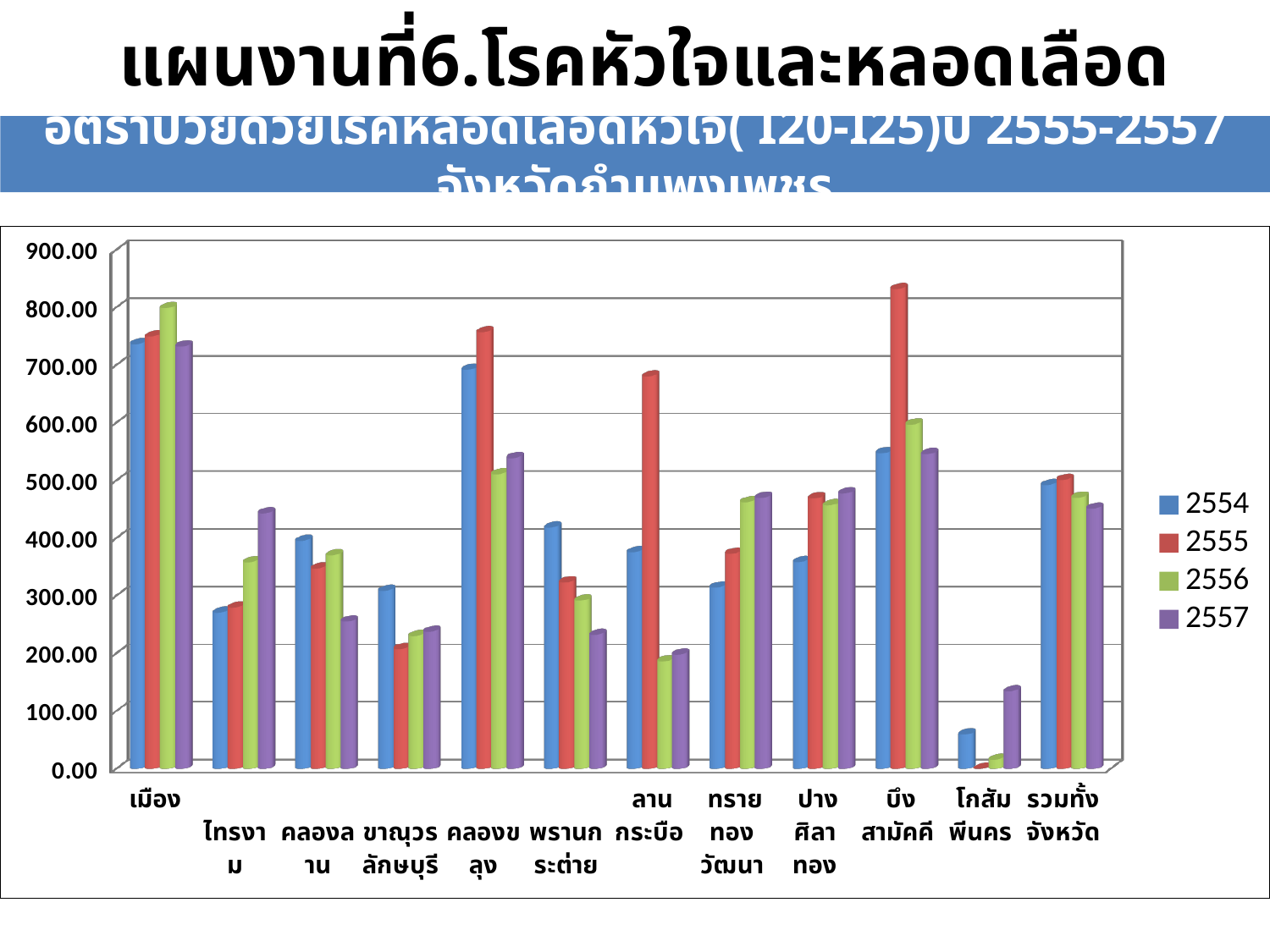
Which series does the legend list first? 2554 Which category has the highest value for the 2555 series? บึงสามัคคี For ลานกระบือ, which is larger: the 2554 value or the 2555 value? 2555 Which series has the highest value for เมือง? 2556 Which series has the highest value for บึงสามัคคี? 2555 How many series does the legend list? 4 Is the value for โกสัมพีนคร in the 2554 series greater or less than 100? less What kind of chart is shown on the slide? bar chart How many categories are shown along the x axis? 12 Which category has the lowest value for the 2554 series? โกสัมพีนคร Is the value for บึงสามัคคี in the 2555 series greater or less than 800? greater